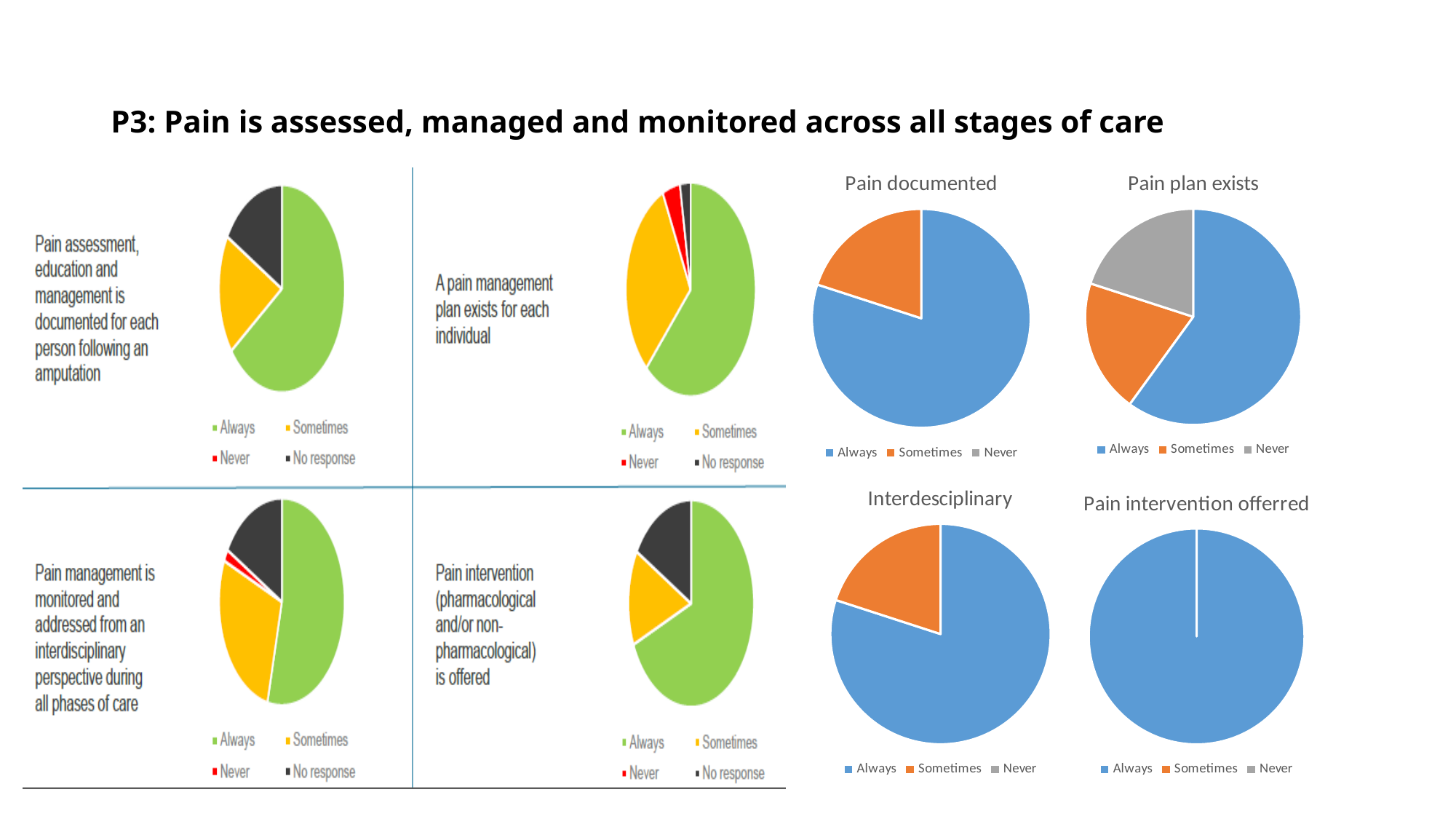
What kind of chart is the "Pain documented" chart? Pie chart What is the title of the chart at the bottom right of the slide? Pain intervention offerred In the "Pain documented" chart, which category has the largest slice? Always In the "Interdesciplinary" chart, which category has the largest slice? Always In the "Pain plan exists" chart, which category has the largest slice? Always How many categories does the legend of the "Pain plan exists" chart list? 3 In the "Pain documented" chart, is the Sometimes slice larger or smaller than the Always slice? Smaller In the "Pain plan exists" chart, is the Always slice larger or smaller than the Never slice? Larger What colour represents "Always" in the "Pain documented" chart? Blue How many categories does the legend of the top-left pie chart ("Pain assessment, education and management is documented for each person following an amputation") list? 4